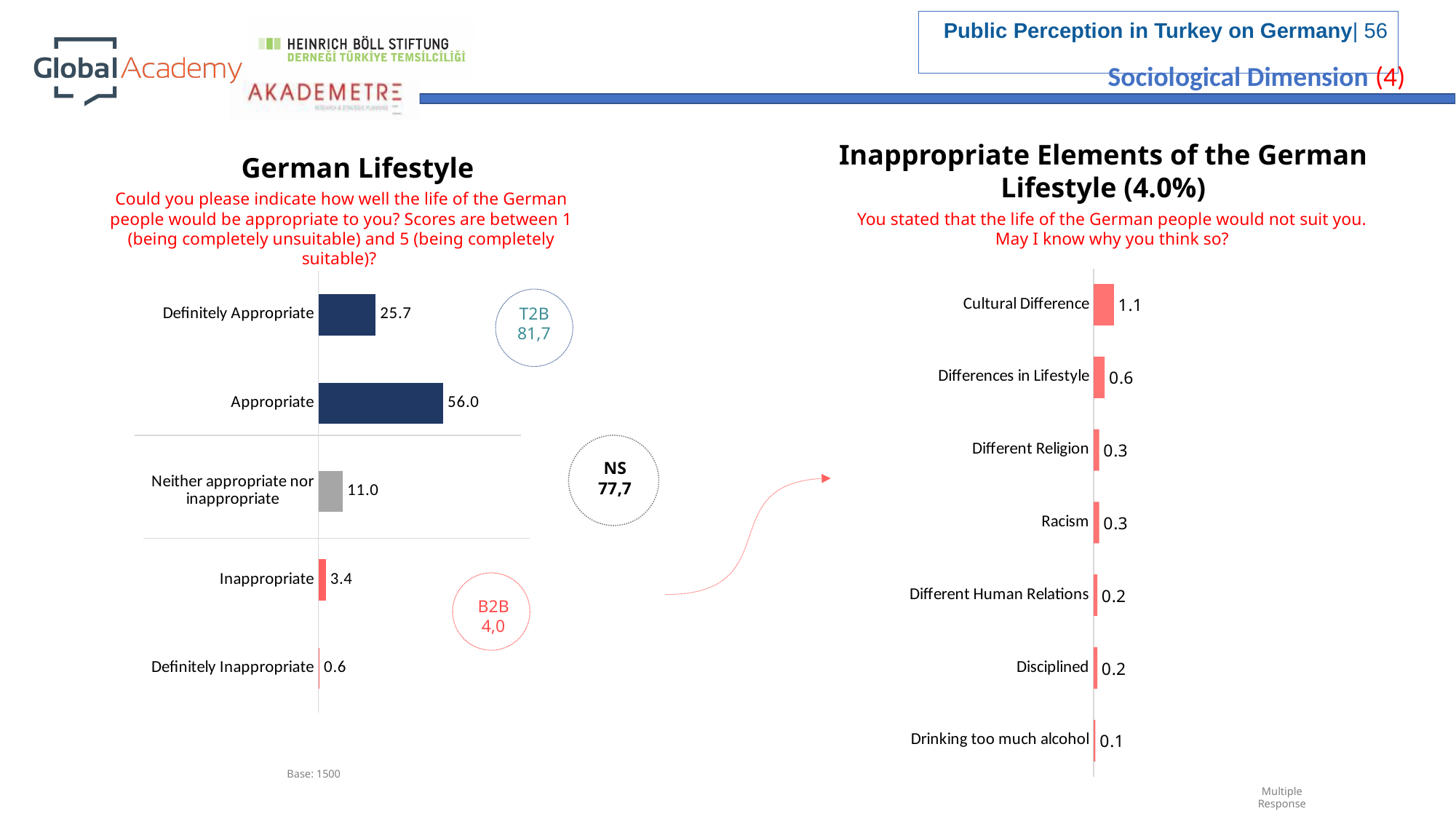
What kind of chart is the Inappropriate Elements of the German Lifestyle chart? Bar chart In the German Lifestyle chart, which category has the lowest value? Definitely Inappropriate In the German Lifestyle chart, what is the value for Appropriate? 56.0 In the German Lifestyle chart, what is the difference between Appropriate and Definitely Appropriate? 30.3 In the German Lifestyle chart, which is larger: Inappropriate or Neither appropriate nor inappropriate? Neither appropriate nor inappropriate How many categories does the Inappropriate Elements of the German Lifestyle chart show? 7 In the Inappropriate Elements of the German Lifestyle chart, what is the value for Cultural Difference? 1.1 In the Inappropriate Elements of the German Lifestyle chart, what is the value for Drinking too much alcohol? 0.1 In the German Lifestyle chart, what is the value for Neither appropriate nor inappropriate? 11.0 In the Inappropriate Elements of the German Lifestyle chart, which category has the highest value? Cultural Difference How many categories does the German Lifestyle chart show? 5 In the German Lifestyle chart, which category has the highest value? Appropriate